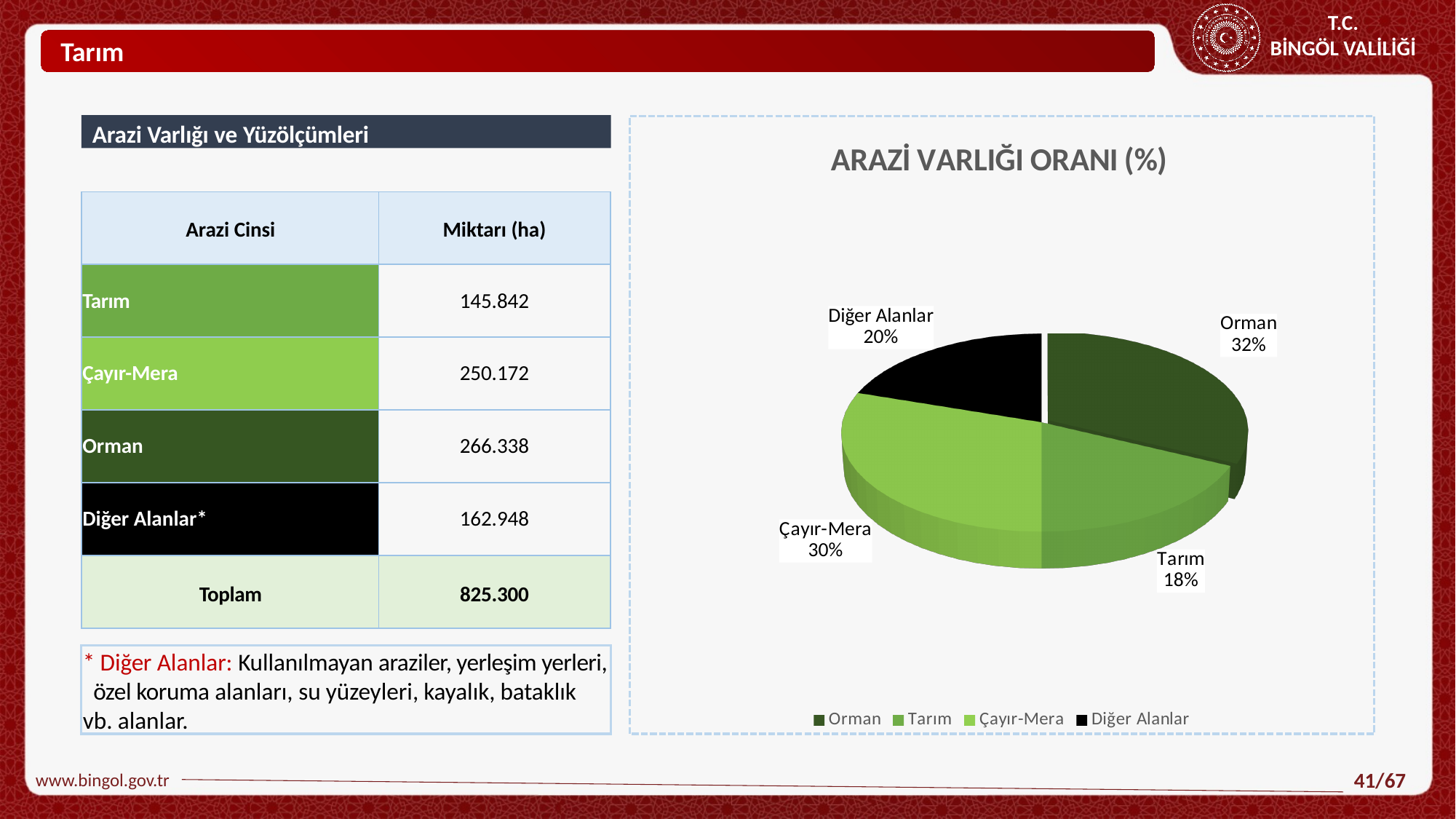
What share of the pie does Tarım have? 18% What is the difference in percentage points between the Orman and Tarım slices? 14 What share of the pie does Diğer Alanlar have? 20% Which slice of the pie chart is the smallest? Tarım What kind of chart is shown on the slide? pie chart What is the title of the pie chart? ARAZİ VARLIĞI ORANI (%) How many slices does the pie chart have? 4 Which slice is larger, Çayır-Mera or Diğer Alanlar? Çayır-Mera What share of the pie does Orman have? 32% Which slice of the pie chart is the largest? Orman How many entries does the legend of the pie chart list? 4